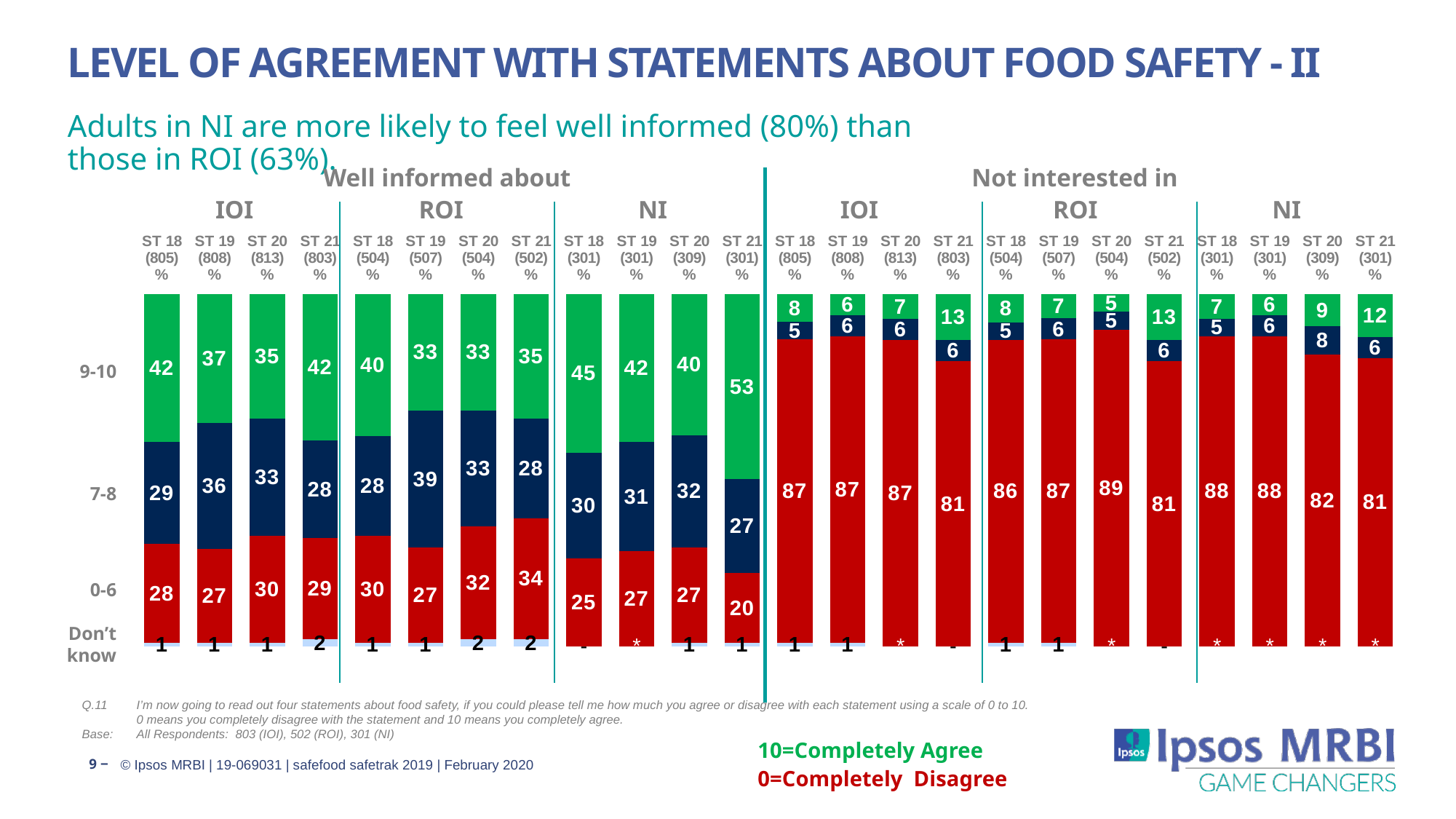
In the 'Not interested in' section, what is the 9-10 value for IOI in ST 21? 13 In the 'Well informed about' section, which has the larger 0-6 value: IOI ST 21 or ROI ST 21? ROI ST 21 In the 'Well informed about' section, what is the combined 9-10 and 7-8 value for NI in ST 21? 80 How many bars are shown in the 'Well informed about' section? 12 In the 'Well informed about' section, which bar has the highest 9-10 value? NI ST 21 In the 'Well informed about' section, what is the difference between the 9-10 value for NI ST 21 and the 9-10 value for ROI ST 21? 18 Which rating band does the green segment of each bar represent? 9-10 In the 'Not interested in' section, which bar has the highest 0-6 value? ROI ST 20 In the 'Well informed about' section, what is the 7-8 value for ROI in ST 19? 39 In the 'Well informed about' section, what percentage of NI respondents in ST 21 gave a 9-10 rating? 53 What type of chart is shown on the slide? Stacked bar chart In the 'Not interested in' section, what percentage of ROI respondents in ST 20 gave a 0-6 rating? 89